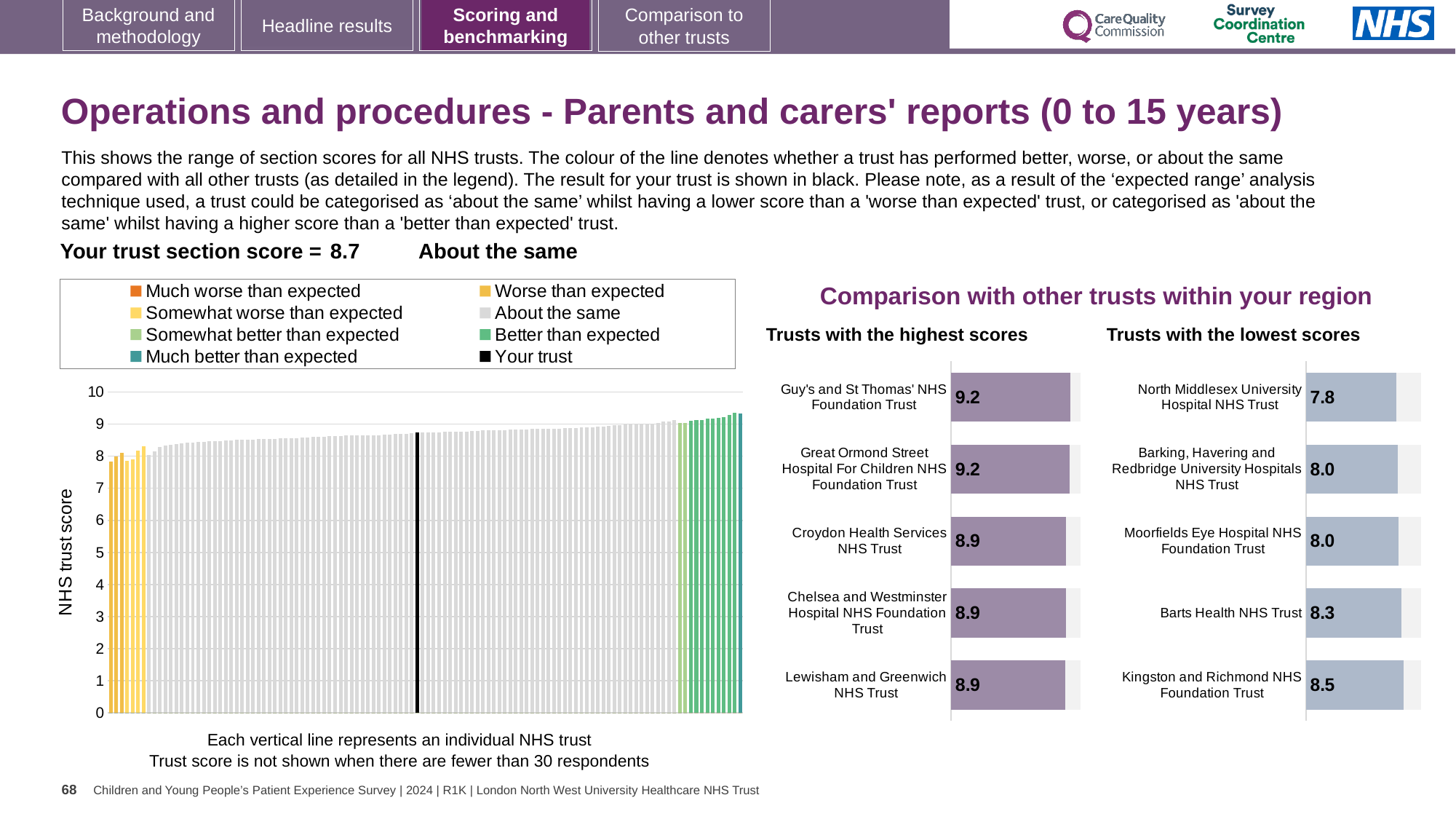
In the main chart on the left, is the value for 'Your trust' greater or less than 8? greater In the 'Trusts with the lowest scores' chart, what is the score for Barts Health NHS Trust? 8.3 In the 'Trusts with the highest scores' chart, what is the score for Guy's and St Thomas' NHS Foundation Trust? 9.2 In the 'Trusts with the lowest scores' chart, what is the difference between the scores of Kingston and Richmond NHS Foundation Trust and North Middlesex University Hospital NHS Trust? 0.7 How many trusts are listed in the 'Trusts with the highest scores' chart? 5 What kind of chart is the main chart on the left showing NHS trust scores? Bar chart In the 'Trusts with the lowest scores' chart, which trust has the highest score? Kingston and Richmond NHS Foundation Trust In the 'Trusts with the highest scores' chart, what is the difference between the scores of Guy's and St Thomas' NHS Foundation Trust and Lewisham and Greenwich NHS Trust? 0.3 In the 'Trusts with the lowest scores' chart, which trust has the lowest score? North Middlesex University Hospital NHS Trust How many entries does the legend of the main chart on the left list? 8 In the 'Trusts with the highest scores' chart, what is the score for Croydon Health Services NHS Trust? 8.9 In the 'Trusts with the lowest scores' chart, which has the larger score: Barts Health NHS Trust or Kingston and Richmond NHS Foundation Trust? Kingston and Richmond NHS Foundation Trust